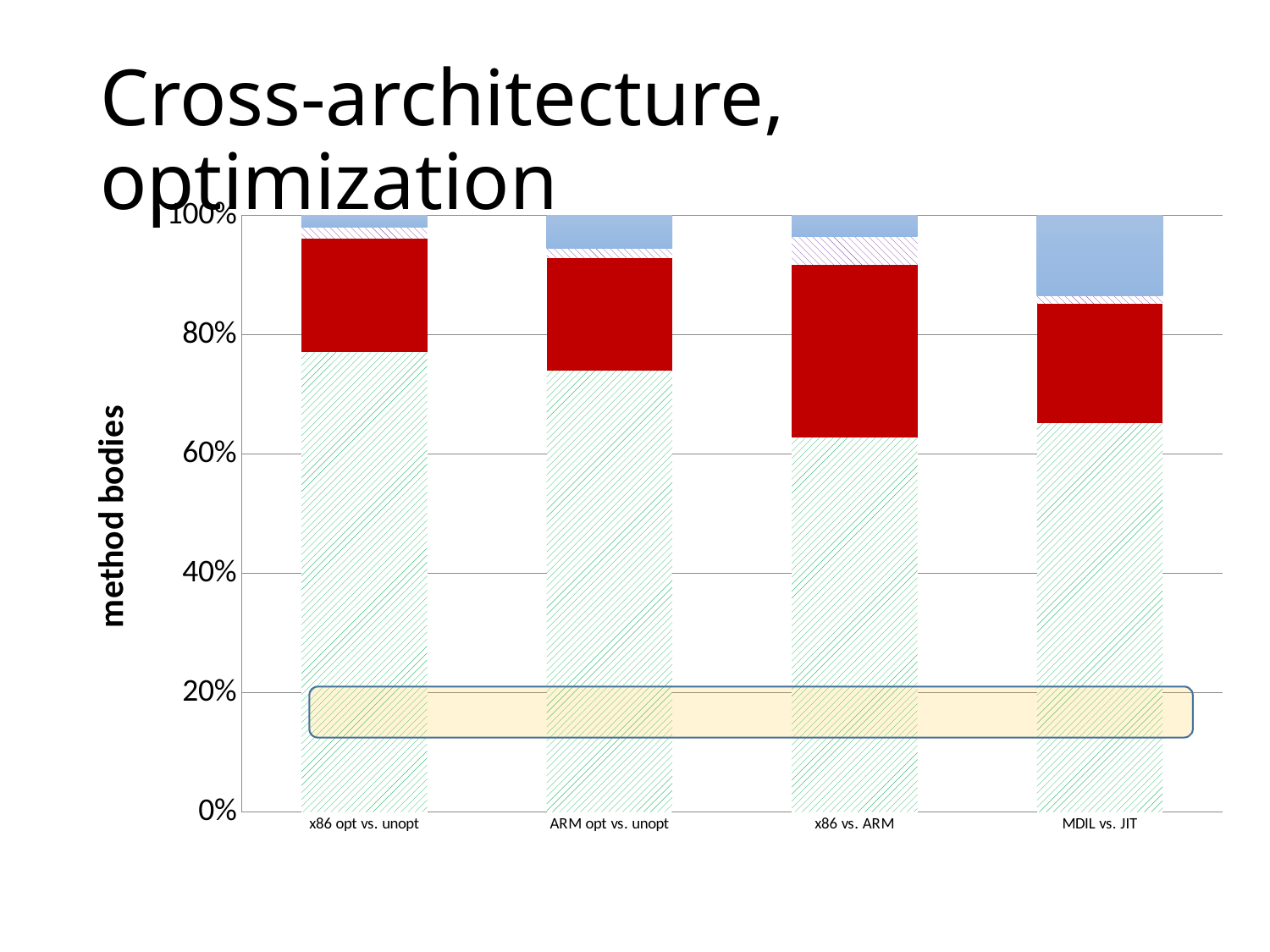
What is the label of the vertical axis of the chart? method bodies What kind of chart is shown on the slide? stacked bar chart What is the title of the slide containing the chart? Cross-architecture, optimization What is the total height of each stacked bar in the chart? 100% Is the top of the red segment for x86 opt vs. unopt greater or less than 80%? greater Is the top of the bottom hatched segment for x86 vs. ARM greater or less than 60%? greater Which category has the largest red segment? x86 vs. ARM Which category has the largest blue (top) segment? MDIL vs. JIT How many categories are shown along the x axis of the chart? 4 Is the top of the bottom hatched segment for MDIL vs. JIT greater or less than 80%? less Which has the larger bottom hatched segment: x86 opt vs. unopt or x86 vs. ARM? x86 opt vs. unopt